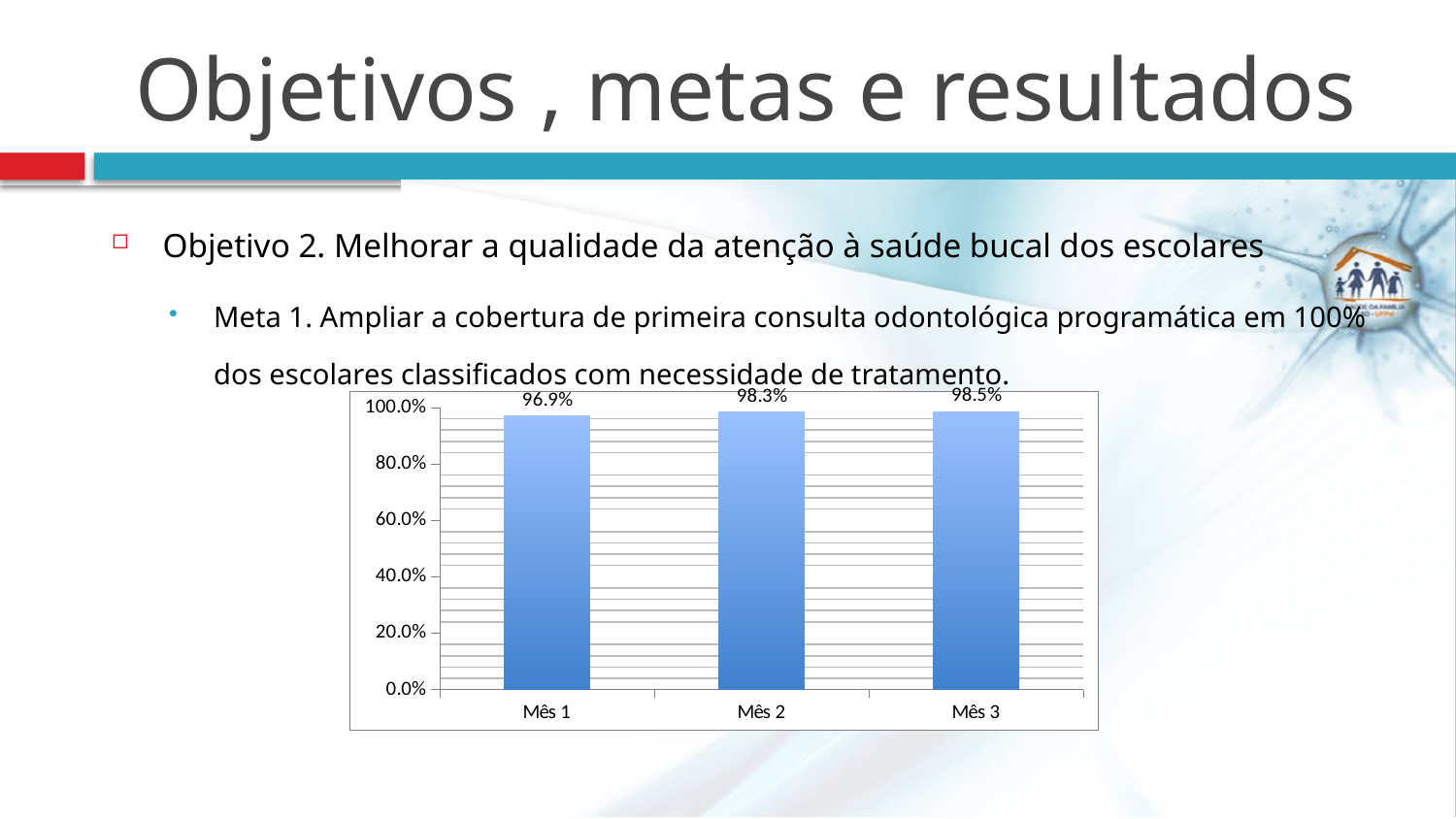
Is the value for Mês 1 greater or less than 80.0%? greater Which is larger, the value for Mês 1 or the value for Mês 3? Mês 3 How many months are shown on the x axis? 3 What is the difference between the values for Mês 3 and Mês 1? 1.6 percentage points What kind of chart is shown on the slide? Bar chart Do the values rise or fall from Mês 1 to Mês 3? Rise Which month has the lowest value? Mês 1 What is the difference between the values for Mês 2 and Mês 1? 1.4 percentage points What is the value for Mês 3? 98.5% What is the value for Mês 1? 96.9% What is the value for Mês 2? 98.3% Which month has the highest value according to the data labels? Mês 3